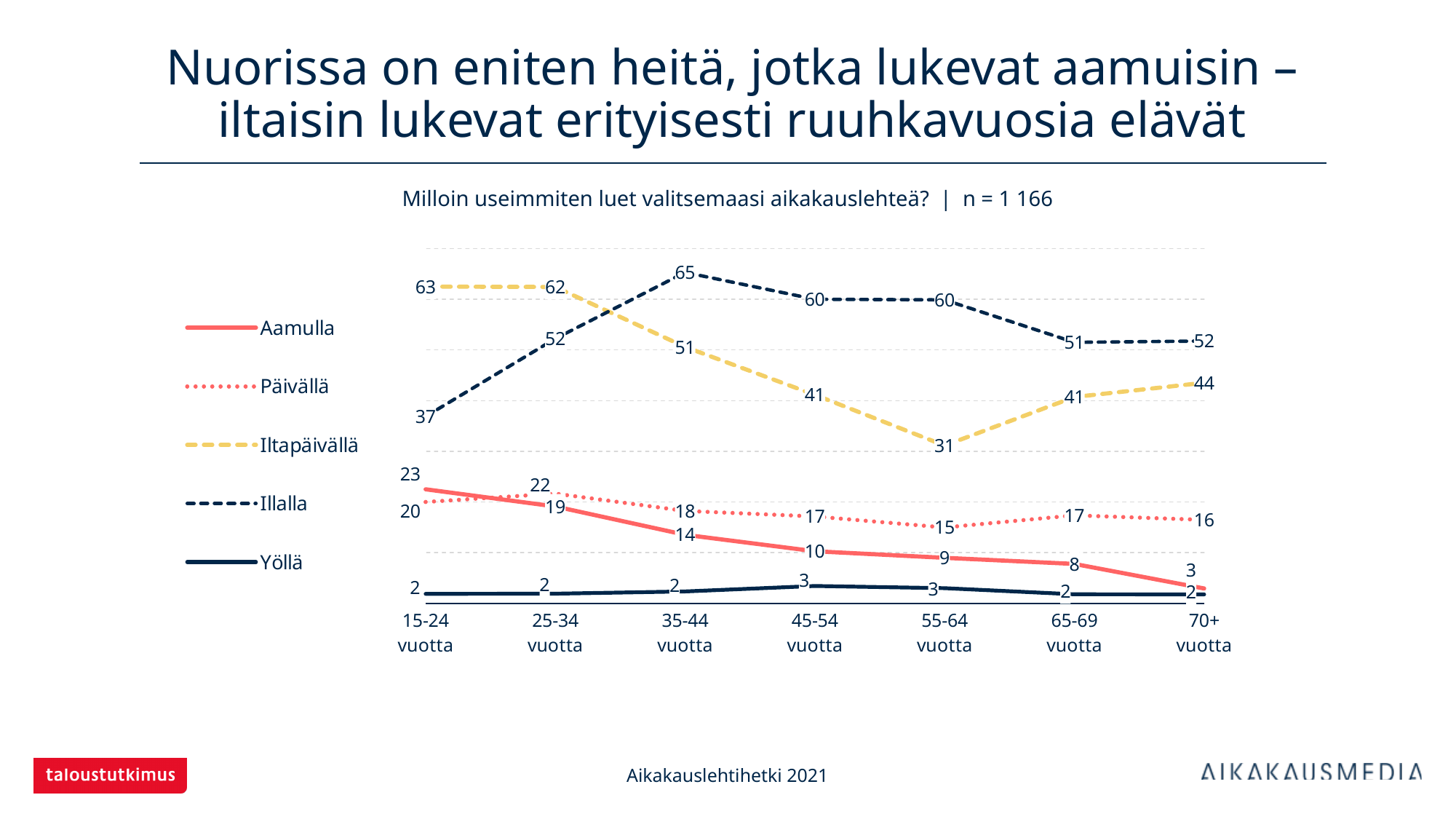
In which age group is the Iltapäivällä value lowest? 55-64 vuotta In which age group is the Aamulla value highest? 15-24 vuotta How many series does the legend list? 5 What is the value for Iltapäivällä in the 15-24 vuotta age group? 63 What is the value for Illalla in the 35-44 vuotta age group? 65 How many age groups are shown on the x axis? 7 What is the survey question shown above the chart? Milloin useimmiten luet valitsemaasi aikakauslehteä? Which is larger in the 25-34 vuotta age group, Aamulla or Päivällä? Päivällä What is the difference between the Illalla and Iltapäivällä values in the 55-64 vuotta age group? 29 Does the Aamulla value rise or fall from 15-24 vuotta to 70+ vuotta? fall What type of chart is shown on the slide? line chart What is the value for Aamulla in the 70+ vuotta age group? 3